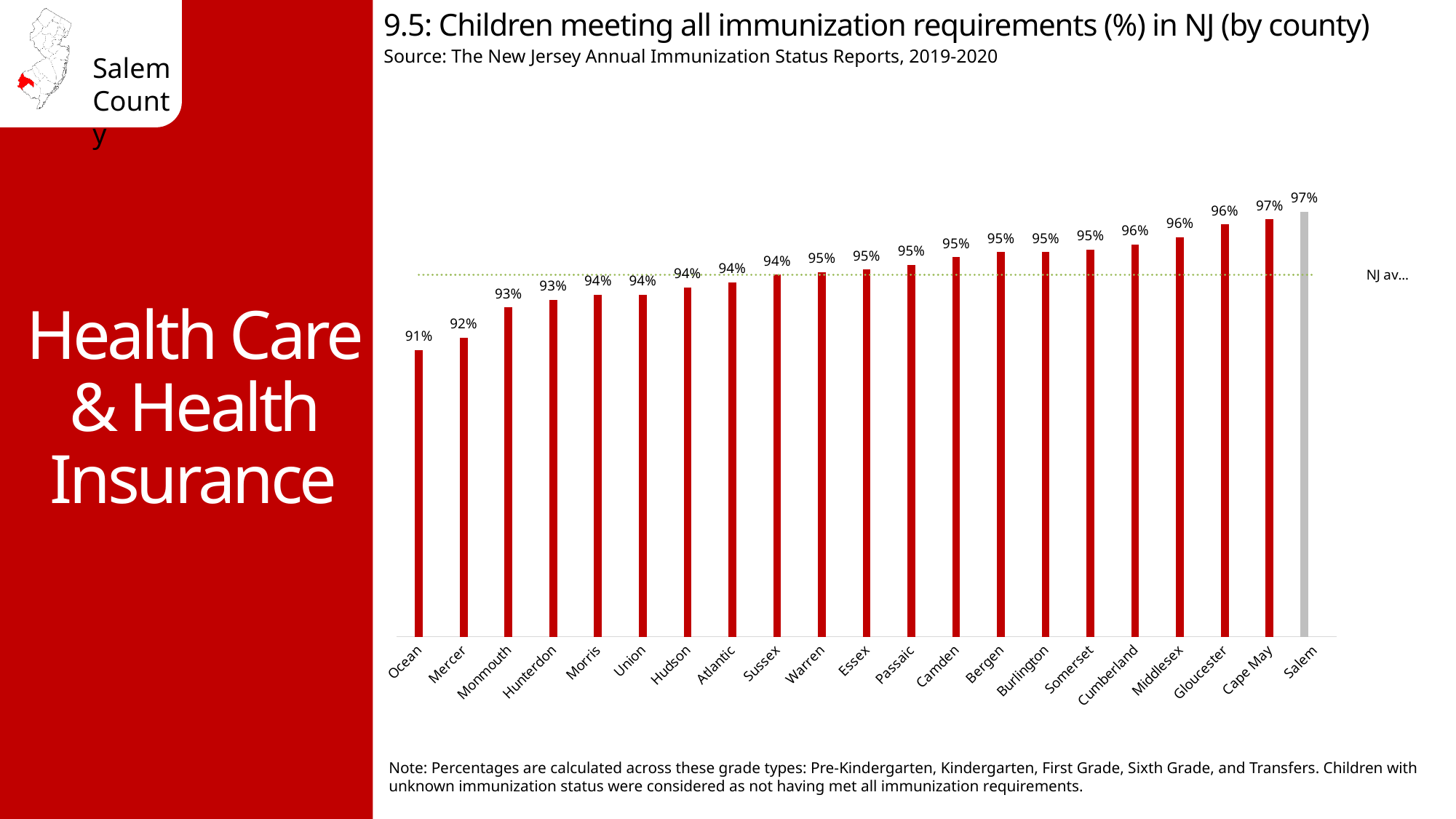
What is the difference between the values for Salem and Ocean counties? 6% Which county's bar is coloured grey instead of red? Salem What is the value shown for Hunterdon County? 93% What kind of chart is shown on the slide? Bar chart Which has a higher value, Monmouth or Cape May? Cape May How many counties are shown on the chart? 21 Which has a higher value, Mercer or Ocean? Mercer Which county has the lowest percentage of children meeting all immunization requirements? Ocean What is the value shown for Salem County? 97% What is the value shown for Cumberland County? 96% Do the values rise or fall moving from left to right along the x axis? Rise What percentage of children in Ocean County met all immunization requirements? 91%